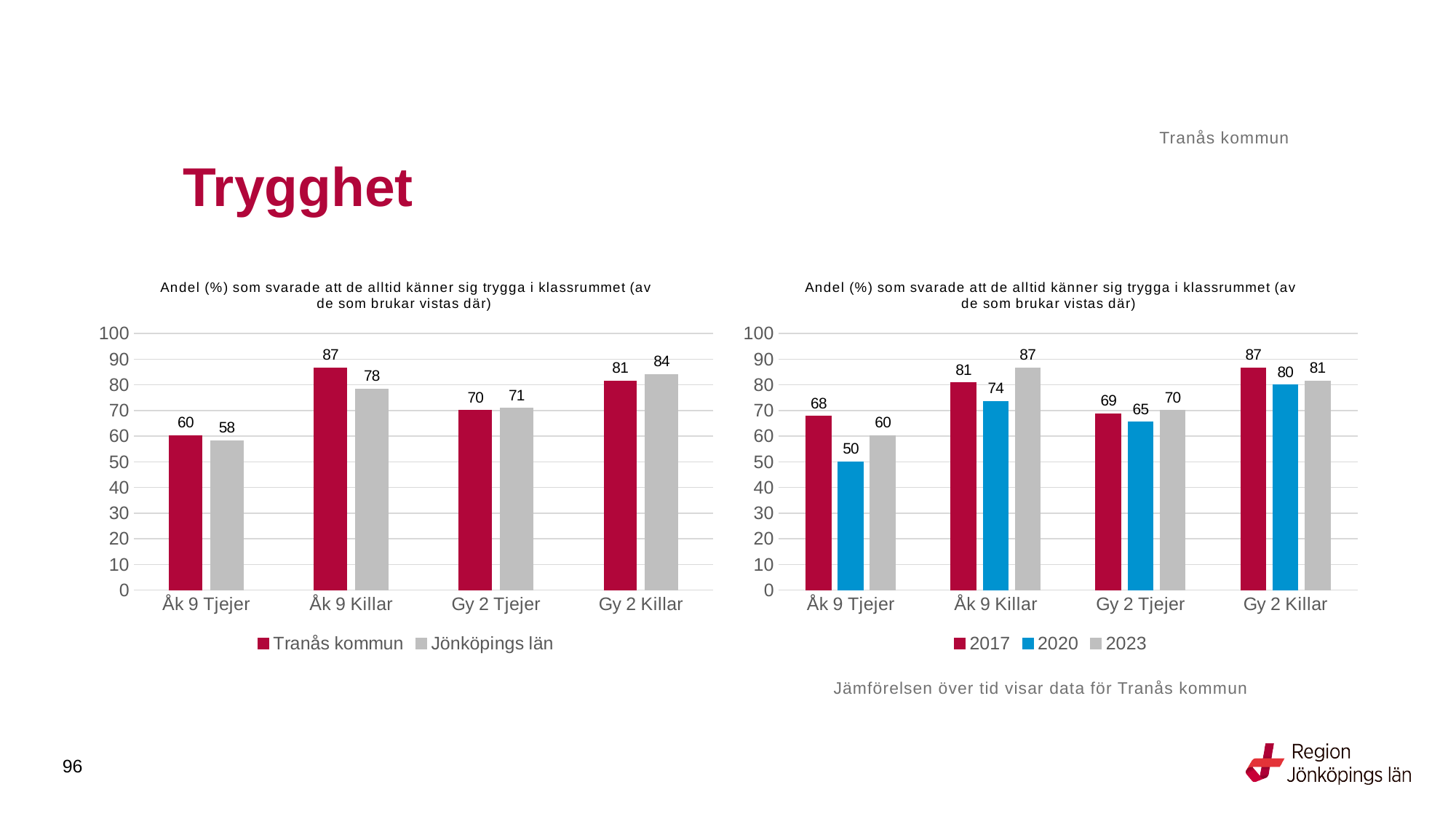
In the left chart, what is the value for Tranås kommun for Åk 9 Killar? 87 In the right chart, which category has the highest value for 2017? Gy 2 Killar What kind of chart is the right chart? Bar chart In the right chart, what is the value for 2020 for Åk 9 Tjejer? 50 In the left chart, what is the value for Jönköpings län for Gy 2 Killar? 84 In the left chart, which category has the lowest value for Jönköpings län? Åk 9 Tjejer How many series does the legend of the left chart list? 2 How many categories are shown on the x axis of the right chart? 4 In the right chart, what is the value for 2023 for Åk 9 Killar? 87 In the left chart, which is larger for Gy 2 Tjejer: Tranås kommun or Jönköpings län? Jönköpings län In the right chart, what is the difference between the 2017 and 2020 values for Åk 9 Tjejer? 18 In the left chart, what is the difference between Tranås kommun and Jönköpings län for Åk 9 Killar? 9